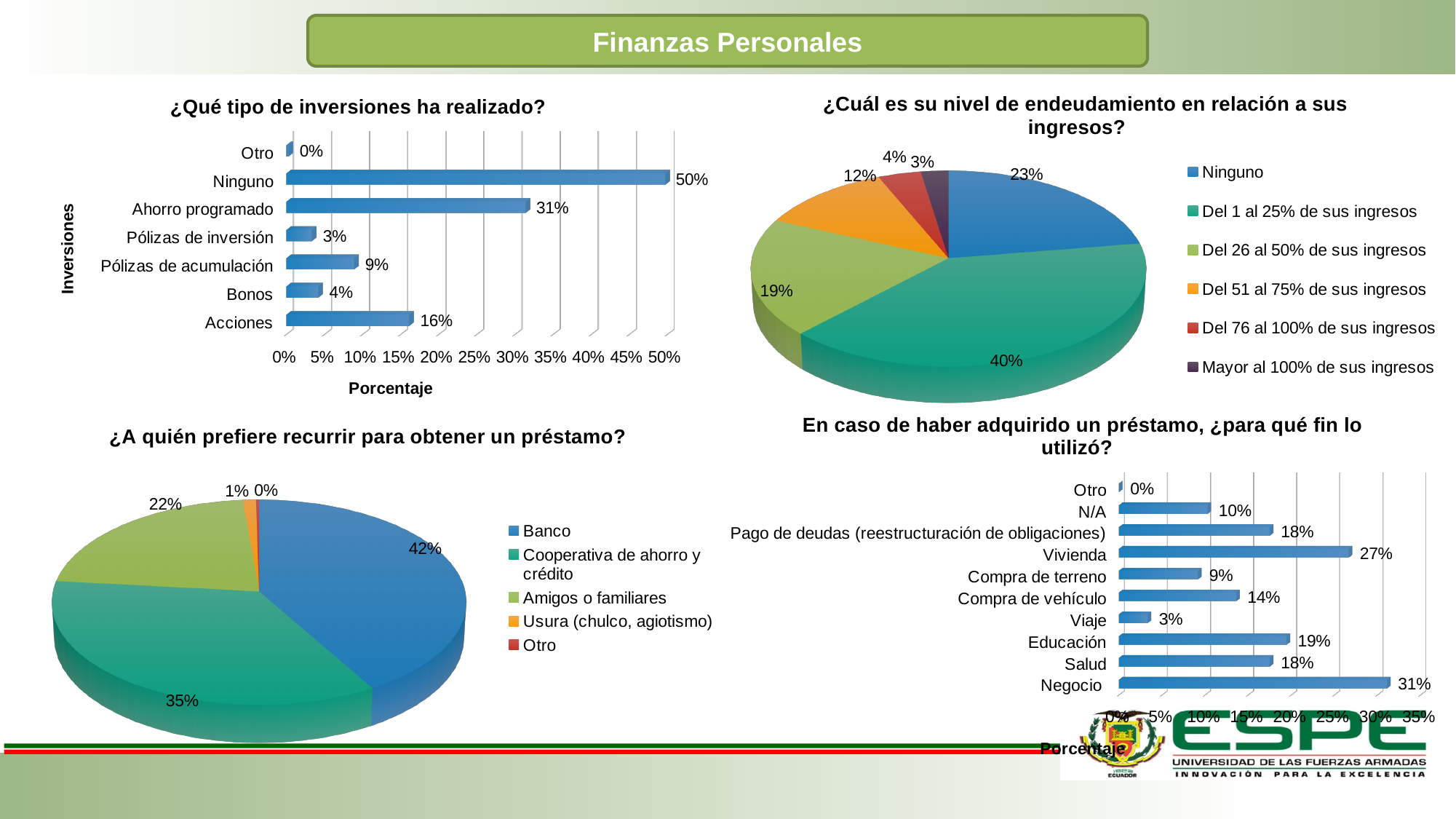
In the chart '¿Qué tipo de inversiones ha realizado?', which category has the highest value? Ninguno In the chart '¿Qué tipo de inversiones ha realizado?', what is the difference between Acciones and Bonos? 12% In the chart '¿Qué tipo de inversiones ha realizado?', how many categories are shown? 7 In the chart '¿Qué tipo de inversiones ha realizado?', what is the value for Ahorro programado? 31% In the chart 'En caso de haber adquirido un préstamo, ¿para qué fin lo utilizó?', what is the value for Vivienda? 27% In the chart '¿Cuál es su nivel de endeudamiento en relación a sus ingresos?', which category has the smallest slice? Mayor al 100% de sus ingresos In the chart '¿Cuál es su nivel de endeudamiento en relación a sus ingresos?', how many entries does the legend list? 6 What kind of chart is '¿A quién prefiere recurrir para obtener un préstamo?'? Pie chart In the chart 'En caso de haber adquirido un préstamo, ¿para qué fin lo utilizó?', which category has the highest value? Negocio In the chart '¿Cuál es su nivel de endeudamiento en relación a sus ingresos?', what share does 'Del 1 al 25% de sus ingresos' have? 40% In the chart '¿A quién prefiere recurrir para obtener un préstamo?', what share does Amigos o familiares have? 22% In the chart '¿A quién prefiere recurrir para obtener un préstamo?', which is larger, Banco or Cooperativa de ahorro y crédito? Banco